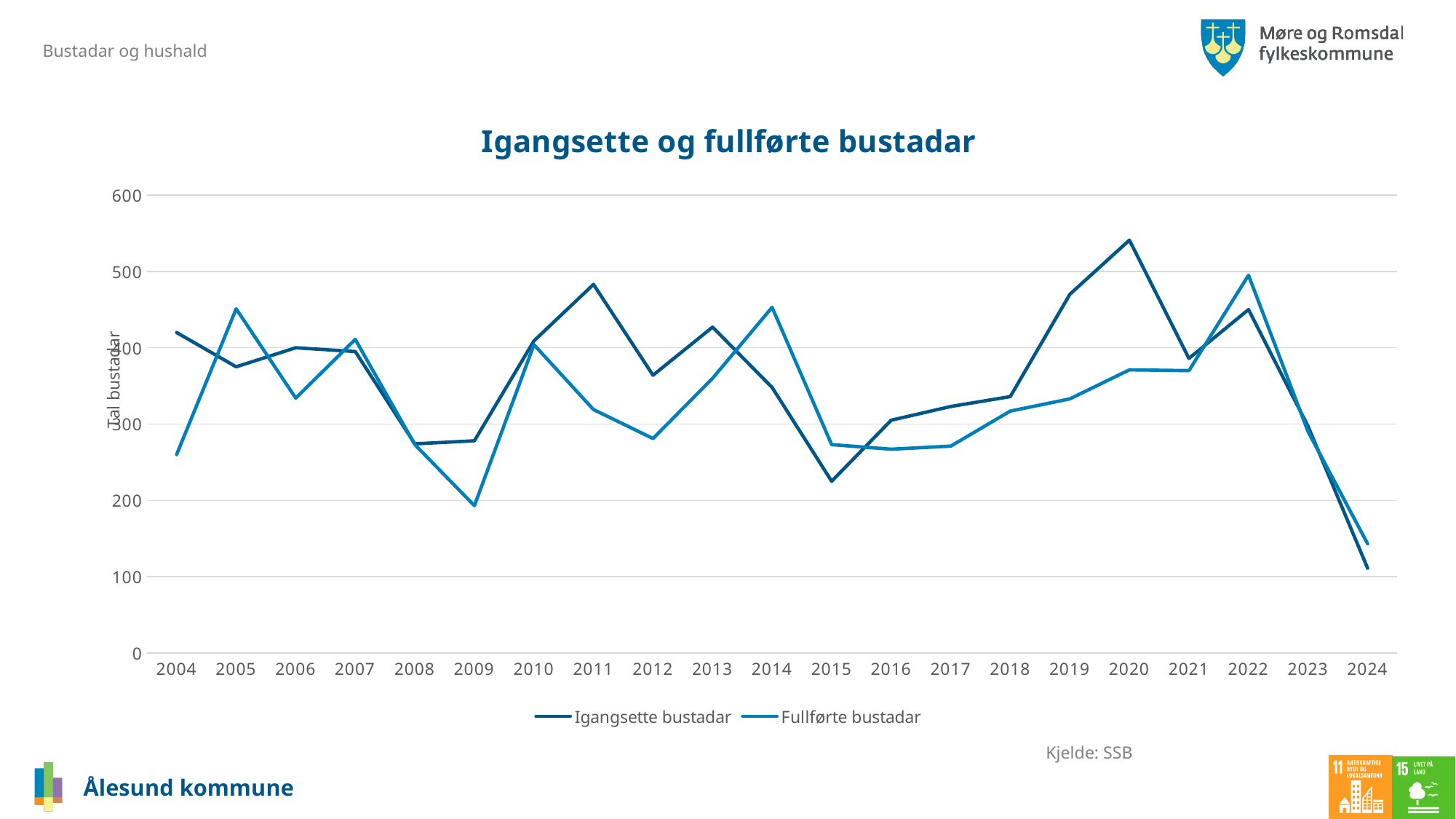
Is the value for Igangsette bustadar in 2024 greater or less than 200? less In which year does the Igangsette bustadar series reach its lowest value? 2024 Is the value for Igangsette bustadar in 2020 greater or less than 500? greater How many series does the legend list? 2 In 2005, which series has the higher value, Igangsette bustadar or Fullførte bustadar? Fullførte bustadar How many years are plotted along the x axis? 21 What type of chart is shown on the slide? Line chart In which year does the Igangsette bustadar series reach its highest value? 2020 Is the value for Fullførte bustadar in 2004 greater or less than 300? less In which year does the Fullførte bustadar series reach its lowest value? 2024 Do the values of both series rise or fall from 2022 to 2024? fall In which year does the Fullførte bustadar series reach its highest value? 2022